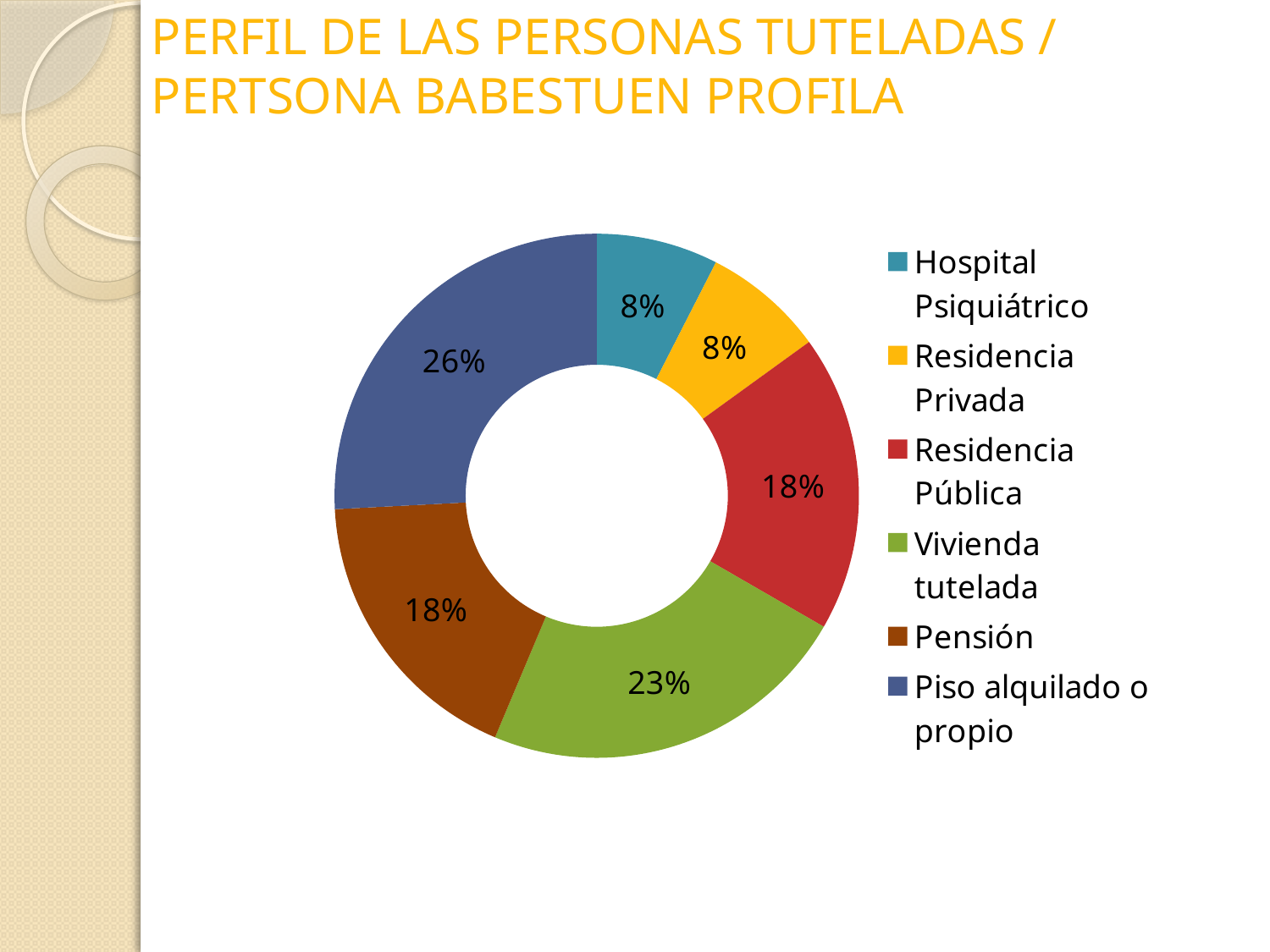
What is the difference between the shares of Piso alquilado o propio and Vivienda tutelada? 3% What share of the chart does Piso alquilado o propio represent? 26% What colour is the slice for Residencia Privada? Yellow What kind of chart is shown on the slide? Doughnut (pie) chart What is the difference between the shares of Residencia Pública and Residencia Privada? 10% Which is larger, the share for Vivienda tutelada or the share for Pensión? Vivienda tutelada What is the value shown for Hospital Psiquiátrico? 8% How many categories does the chart show? 6 What is the value shown for Residencia Pública? 18% What is the value shown for Vivienda tutelada? 23% What is the value shown for Pensión? 18% Which category has the largest share of the chart? Piso alquilado o propio